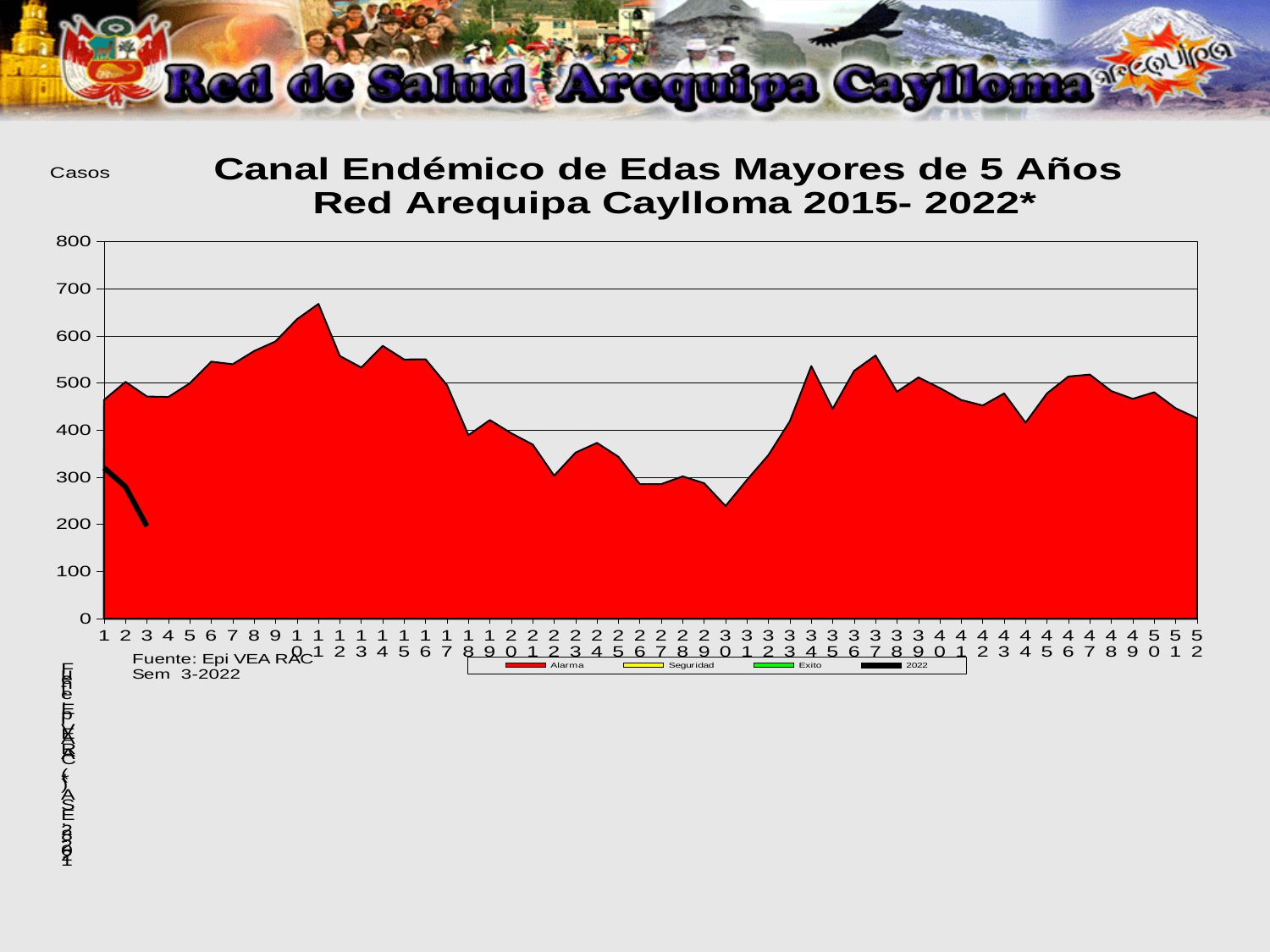
Is the Alarma value at week 30 greater or less than 300? less How many series does the legend list? 4 Is the Alarma value at week 11 greater or less than 600? greater At which week does the Alarma area reach its lowest value? Week 30 What colour is the 2022 series in the legend? Black At which week does the Alarma area reach its highest value? Week 11 What is the title of the chart? Canal Endémico de Edas Mayores de 5 Años Red Arequipa Caylloma 2015- 2022* Does the 2022 line rise or fall from week 1 to week 3? Fall Which is larger, the Alarma value at week 11 or at week 30? Week 11 Is the 2022 value at week 3 greater or less than 300? less How many weeks are shown on the x axis? 52 What kind of chart is this? Area chart with a line